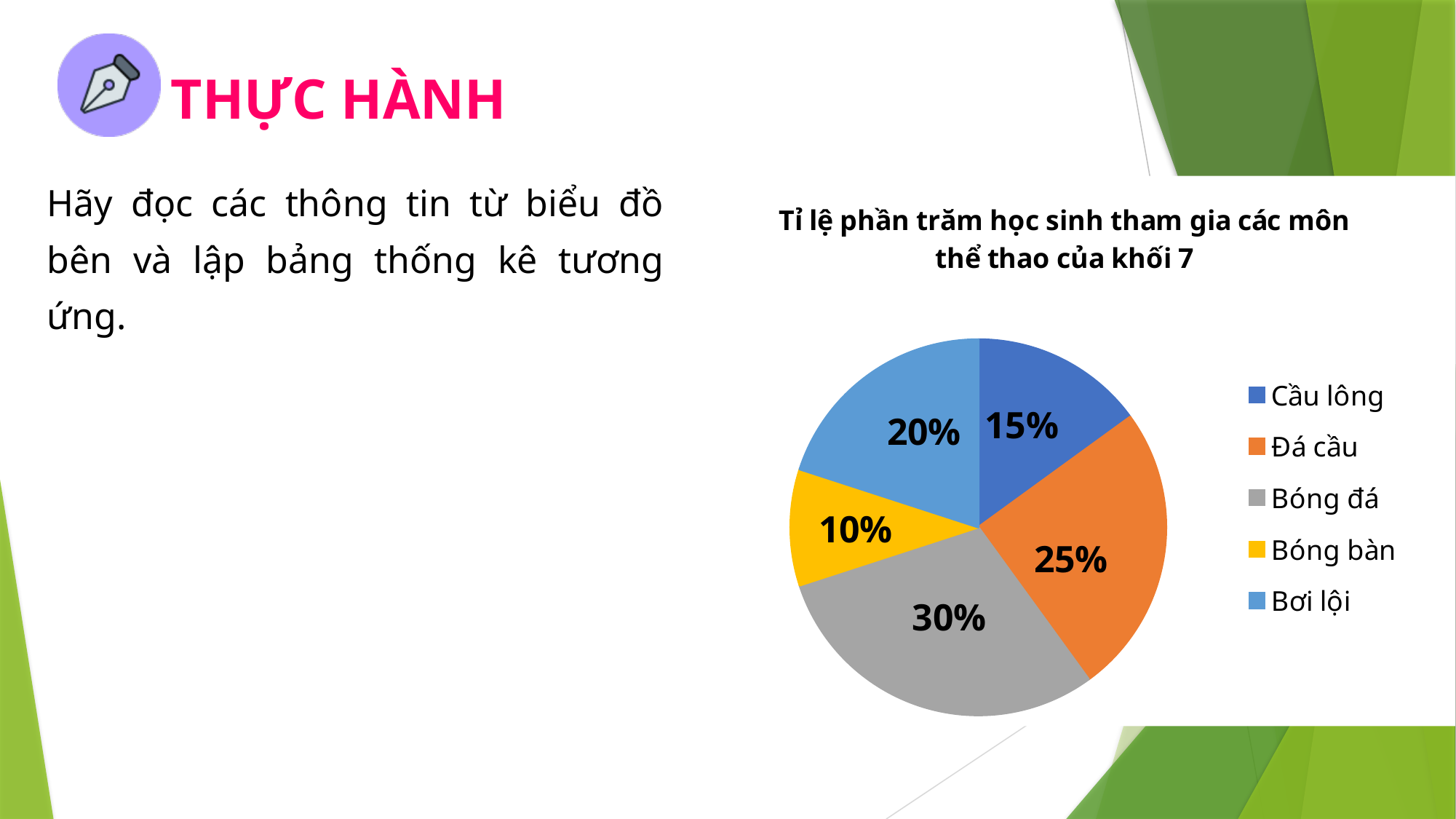
What is the title of the chart? Tỉ lệ phần trăm học sinh tham gia các môn thể thao của khối 7 How many sports are shown in the pie chart? 5 What percentage of students participate in Bóng bàn? 10% What percentage of students participate in Cầu lông? 15% What kind of chart is shown on the slide? Pie chart What percentage of students participate in Bơi lội? 20% What colour is the slice for Bóng bàn? Yellow What is the difference between the shares for Đá cầu and Cầu lông? 10% Which has a larger share, Bơi lội or Đá cầu? Đá cầu What percentage of students participate in Bóng đá? 30% Which sport has the smallest share of students? Bóng bàn Which sport has the largest share of students? Bóng đá